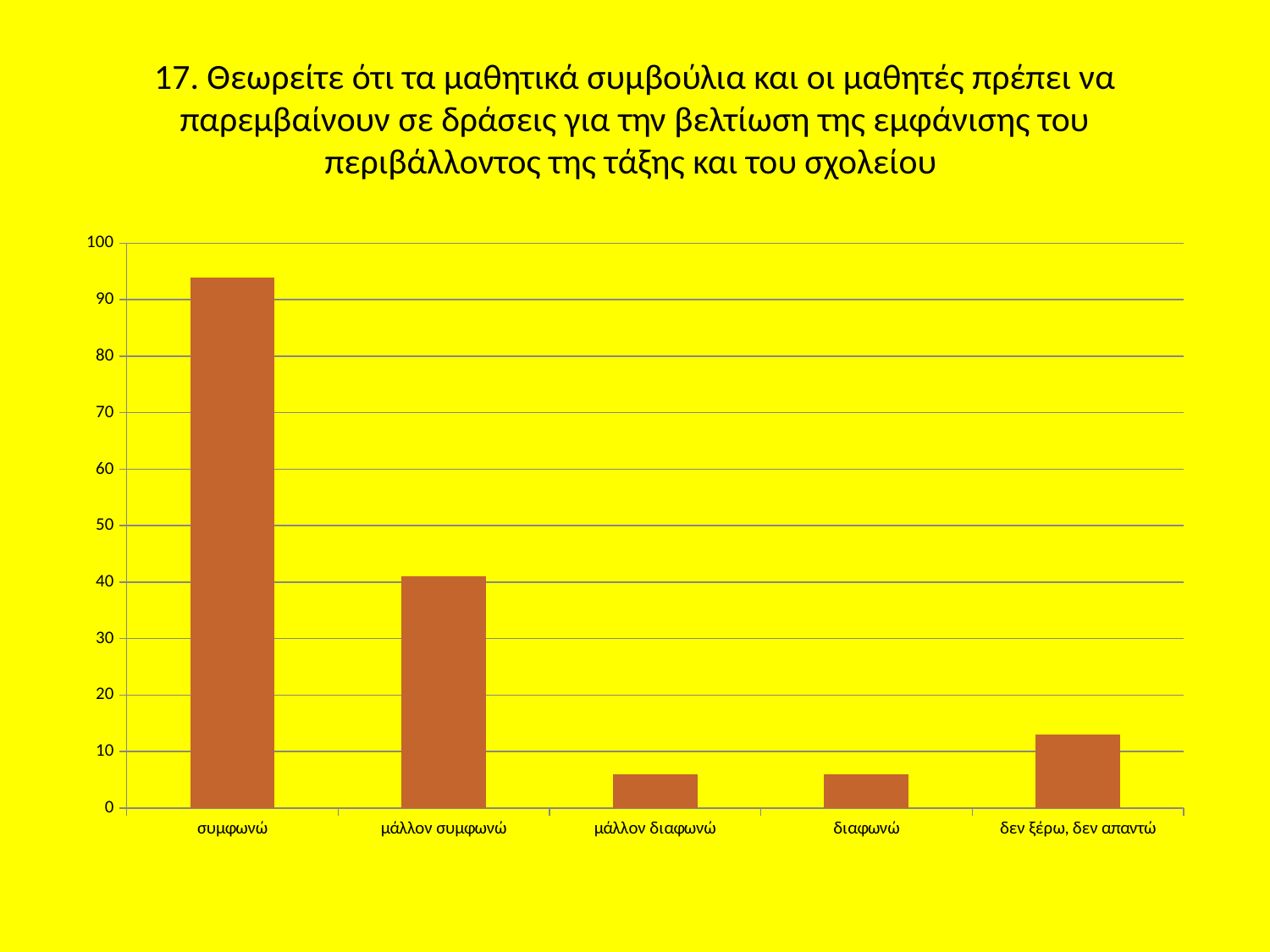
What kind of chart is shown on the slide? bar chart Is the value for μάλλον διαφωνώ greater or less than 10? less How many categories are shown on the x axis of the chart? 5 Which category has the highest bar? συμφωνώ Is the value for συμφωνώ greater or less than 90? greater Which is larger, the value for δεν ξέρω, δεν απαντώ or the value for διαφωνώ? δεν ξέρω, δεν απαντώ Is the value for διαφωνώ greater or less than 10? less What is the highest value shown on the y axis of the chart? 100 Which is larger, the value for συμφωνώ or the value for μάλλον συμφωνώ? συμφωνώ What colour are the bars in the chart? orange